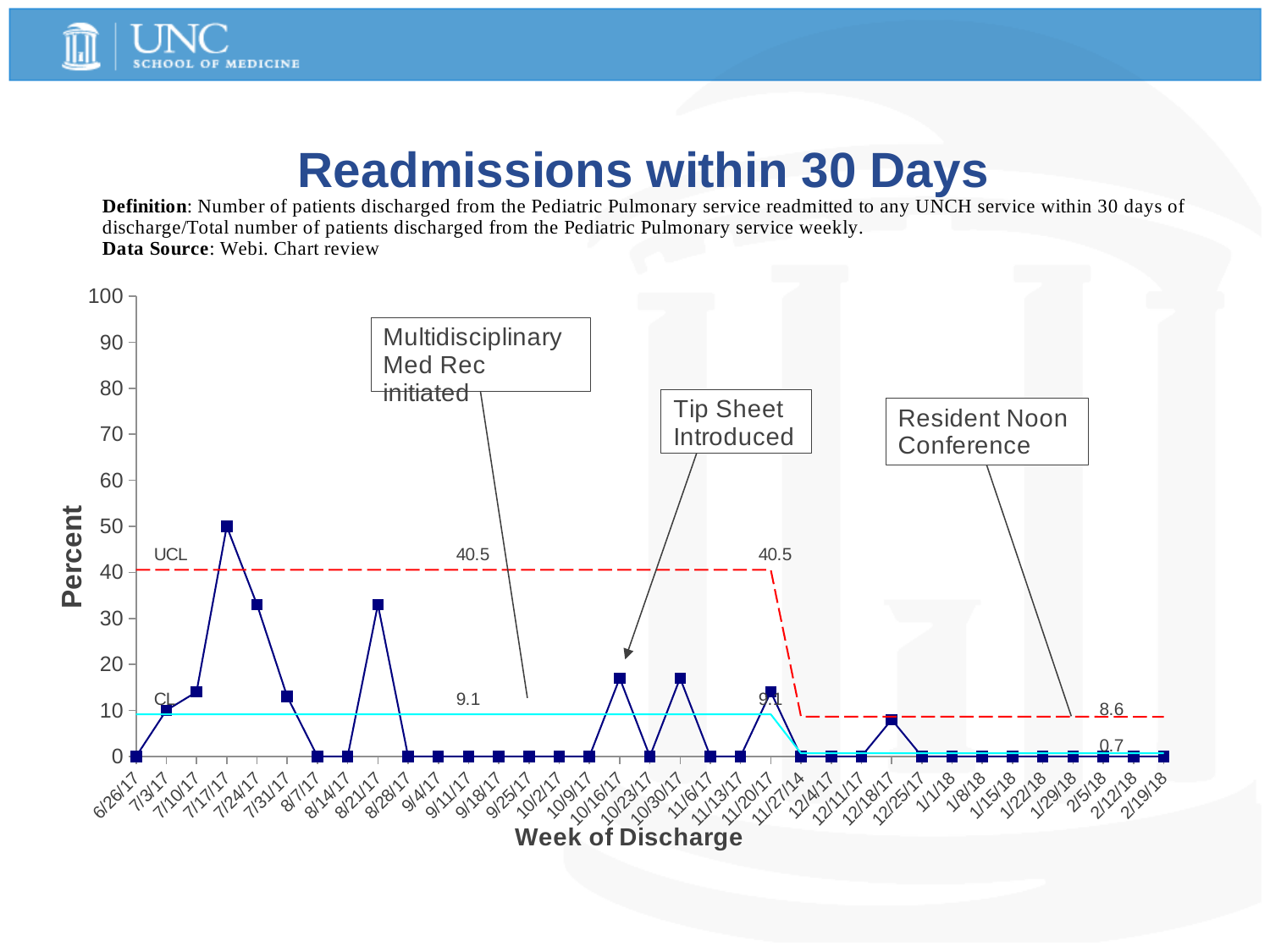
What is the title of the x axis of the chart? Week of Discharge Which week has the larger readmission percentage, 7/17/17 or 8/21/17? 7/17/17 What is the value of the CL line for the weeks before 11/27/17? 9.1 Which week of discharge has the highest readmission percentage? 7/17/17 By how much does the UCL drop from its earlier value (40.5) to its later value (8.6)? 31.9 What is the value of the CL line for the weeks from 11/27/17 onward? 0.7 Is the readmission percentage for the week of 10/16/17 greater or less than 20? less What kind of chart is shown on the slide? line chart What is the readmission percentage for the week of 7/17/17? 50 Is the readmission percentage for the week of 7/24/17 greater or less than 30? greater What is the value of the UCL line for the weeks before 11/27/17? 40.5 What is the value of the UCL line for the weeks from 11/27/17 onward? 8.6